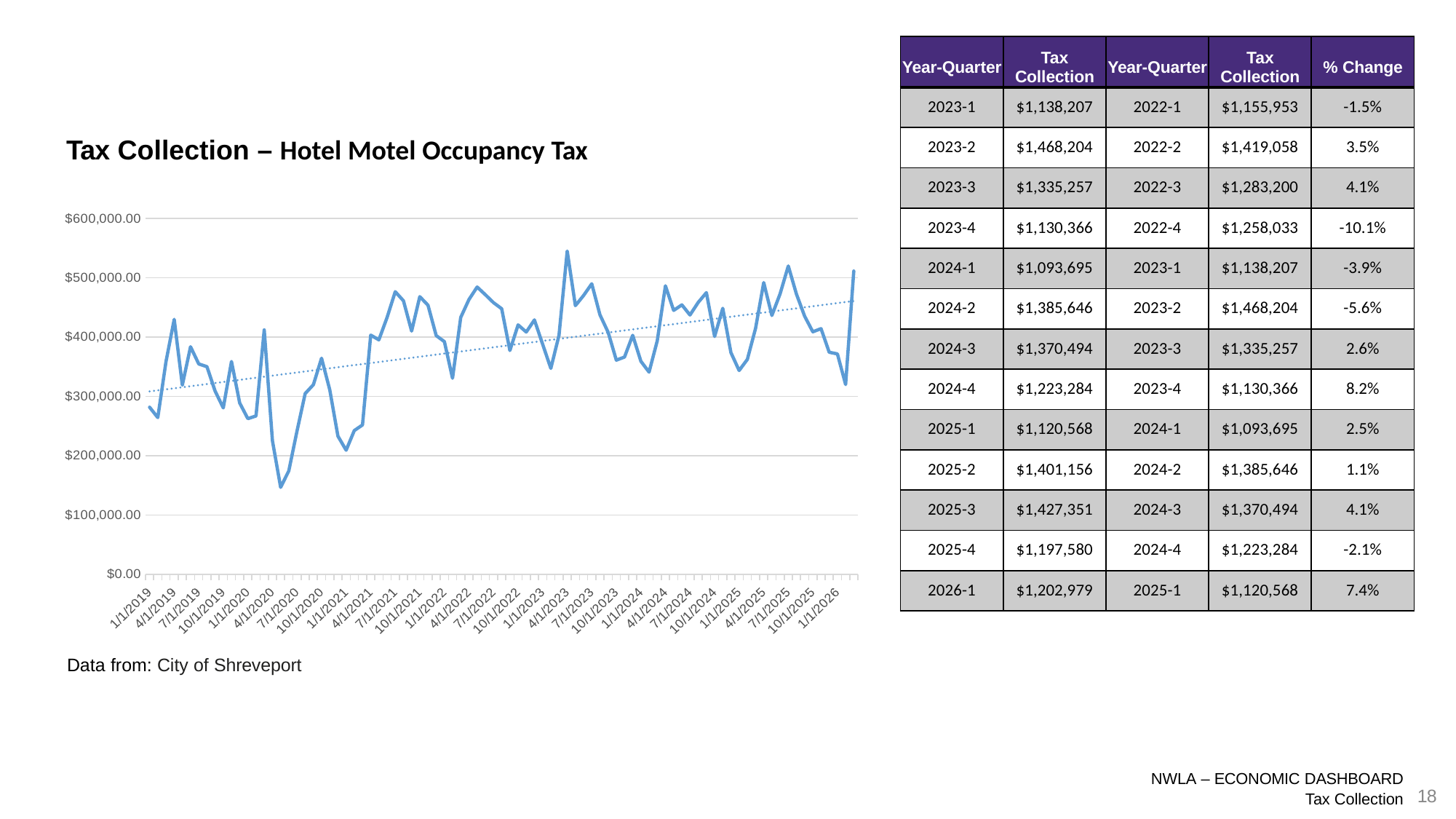
What kind of chart is shown on the slide? line chart What is the highest tick label on the chart's y axis? $600,000.00 Is the value for 4/1/2024 greater or less than $400,000? greater Is the highest value on the chart greater or less than $500,000? greater What is the first date label on the chart's x axis? 1/1/2019 Is the value for 1/1/2020 greater or less than $300,000? less What is the title of the chart? Tax Collection – Hotel Motel Occupancy Tax Overall, do the values on the chart rise or fall from 2019 to 2026? rise Does the dotted trend line on the chart rise or fall from left to right? rise